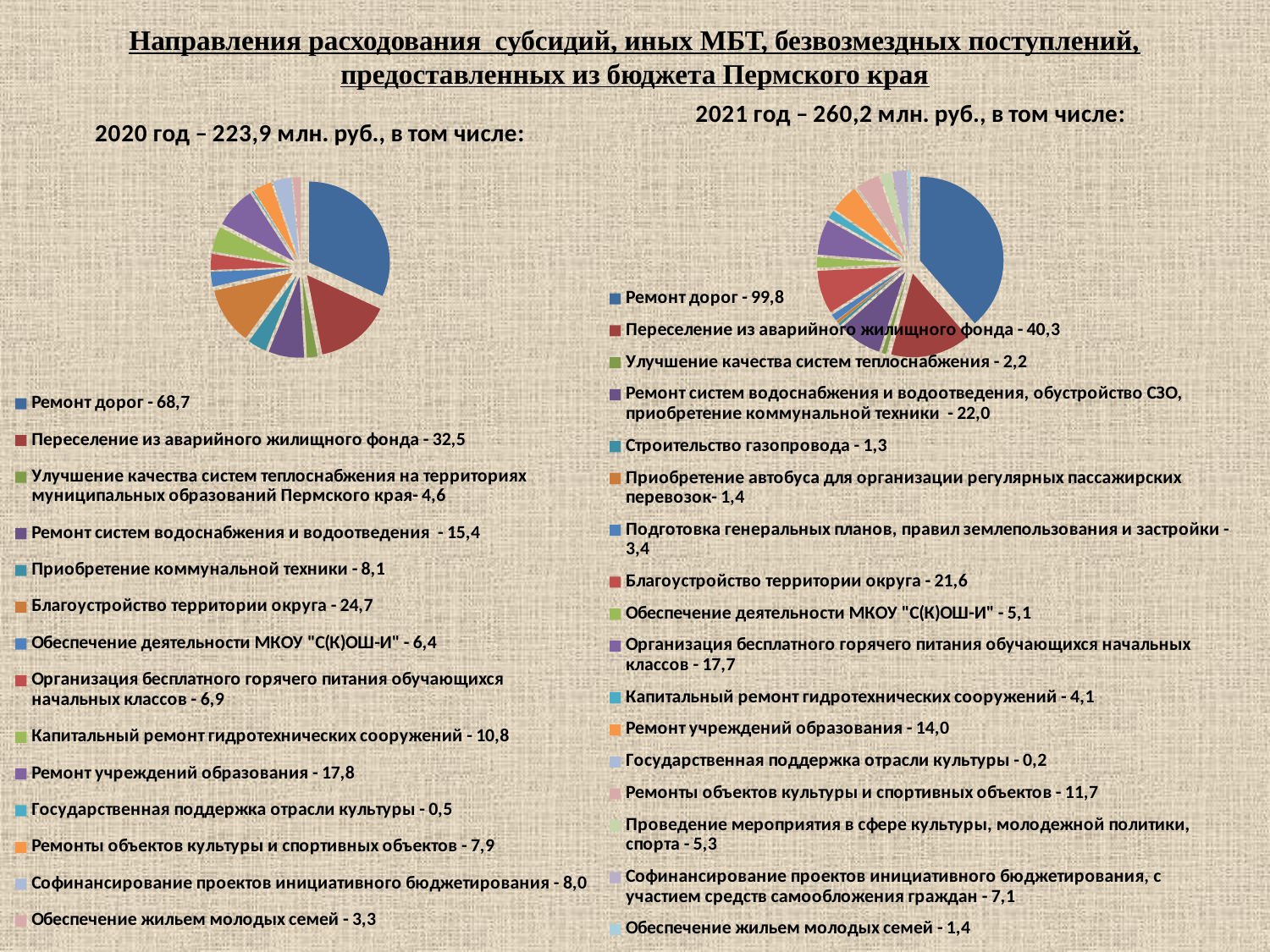
How much larger is the value for Ремонт дорог in the 2021 pie chart than in the 2020 pie chart? 31,1 In the 2020 pie chart, which category has the largest value? Ремонт дорог In the 2021 pie chart, what is the value for Ремонт учреждений образования? 14,0 What total amount is stated for 2021 above the right pie chart? 260,2 млн. руб. In the 2020 pie chart, what is the difference between Благоустройство территории округа and Ремонт учреждений образования? 6,9 What kind of chart is used on the slide for the 2020 and 2021 data? Pie chart In the 2020 pie chart, what is the value for Ремонт дорог? 68,7 How many categories does the legend of the 2021 pie chart list? 17 In the 2021 pie chart, which category has the smallest value? Государственная поддержка отрасли культуры In the 2021 pie chart, what is the value for Благоустройство территории округа? 21,6 In the 2020 pie chart, which category has the smallest value? Государственная поддержка отрасли культуры In the 2021 pie chart, which is larger: Переселение из аварийного жилищного фонда or Организация бесплатного горячего питания обучающихся начальных классов? Переселение из аварийного жилищного фонда